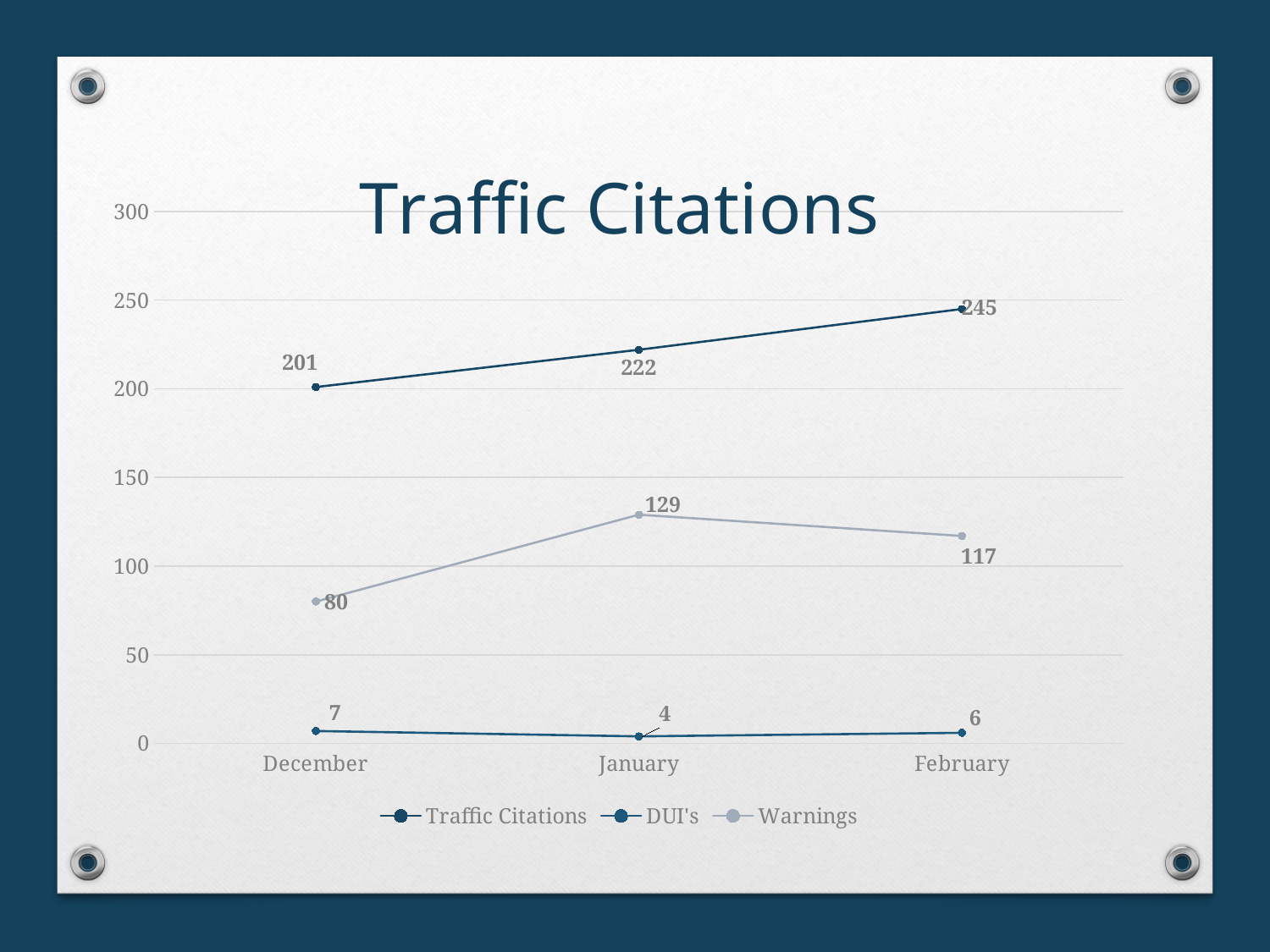
How many series does the legend list? 3 What is the value for DUI's in February? 6 What kind of chart is shown on the slide? line chart What is the value for Traffic Citations in January? 222 How many months are shown on the x axis? 3 Which is larger: Warnings in January or Warnings in February? Warnings in January What is the difference between the Traffic Citations values for February and December? 44 In which month is the DUI's value lowest? January Do the Traffic Citations values rise or fall from December to February? rise Is the value for Warnings in February greater or less than 100? greater In which month is the Traffic Citations value highest? February What is the value for Warnings in December? 80